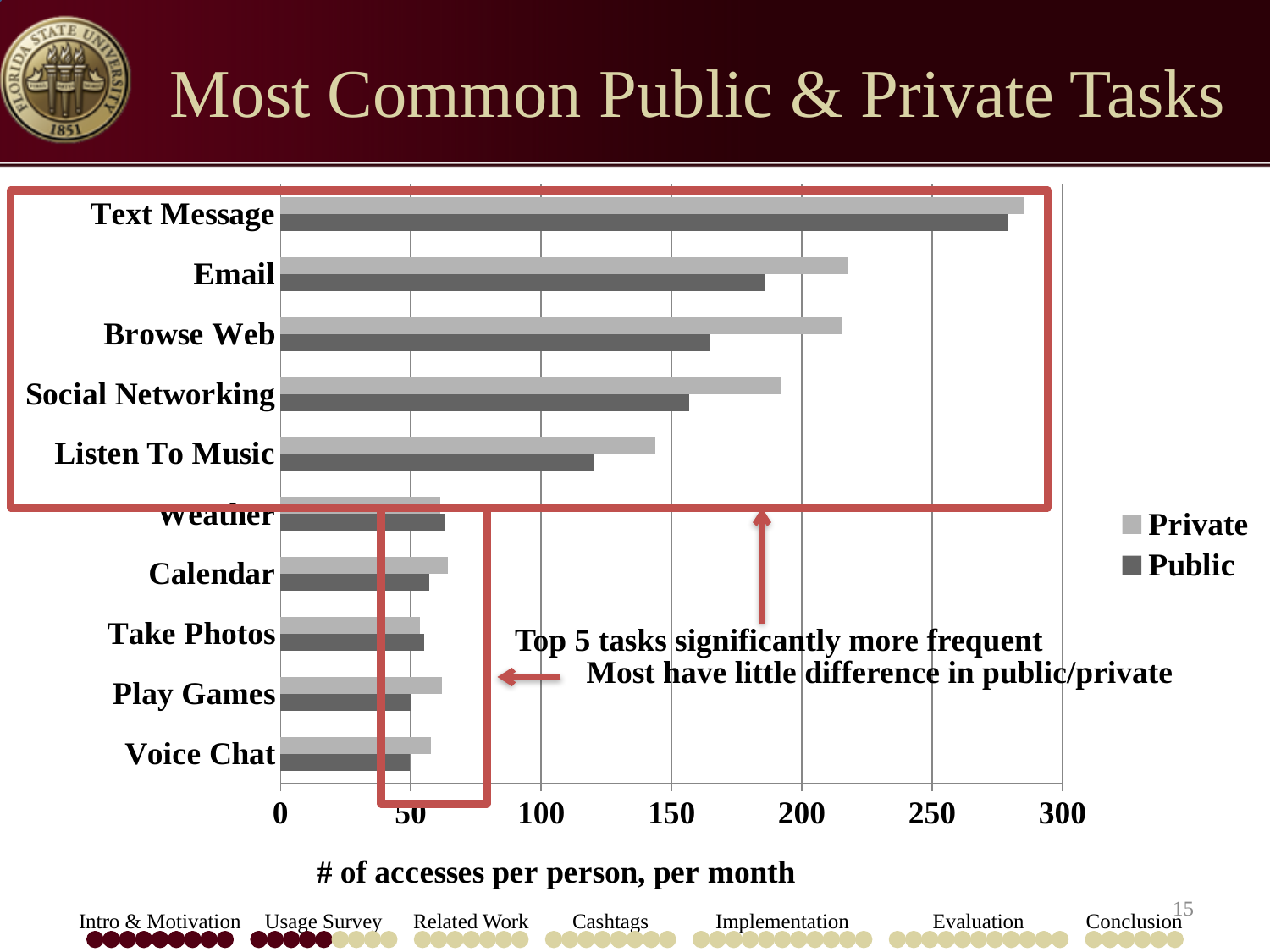
Which task has the highest Public value? Text Message What is the label of the horizontal axis? # of accesses per person, per month Is the Private value for Text Message greater or less than 250? greater Is the Public value for Browse Web greater or less than 200? less Is the Public value for Listen To Music greater or less than 150? less What kind of chart is shown on the slide? bar chart How many series does the legend list? 2 How many task categories are plotted on the chart? 10 Which task has the highest Private value? Text Message Which is larger, the Private value or the Public value for Social Networking? Private Which is larger, the Public value for Email or the Public value for Browse Web? Email